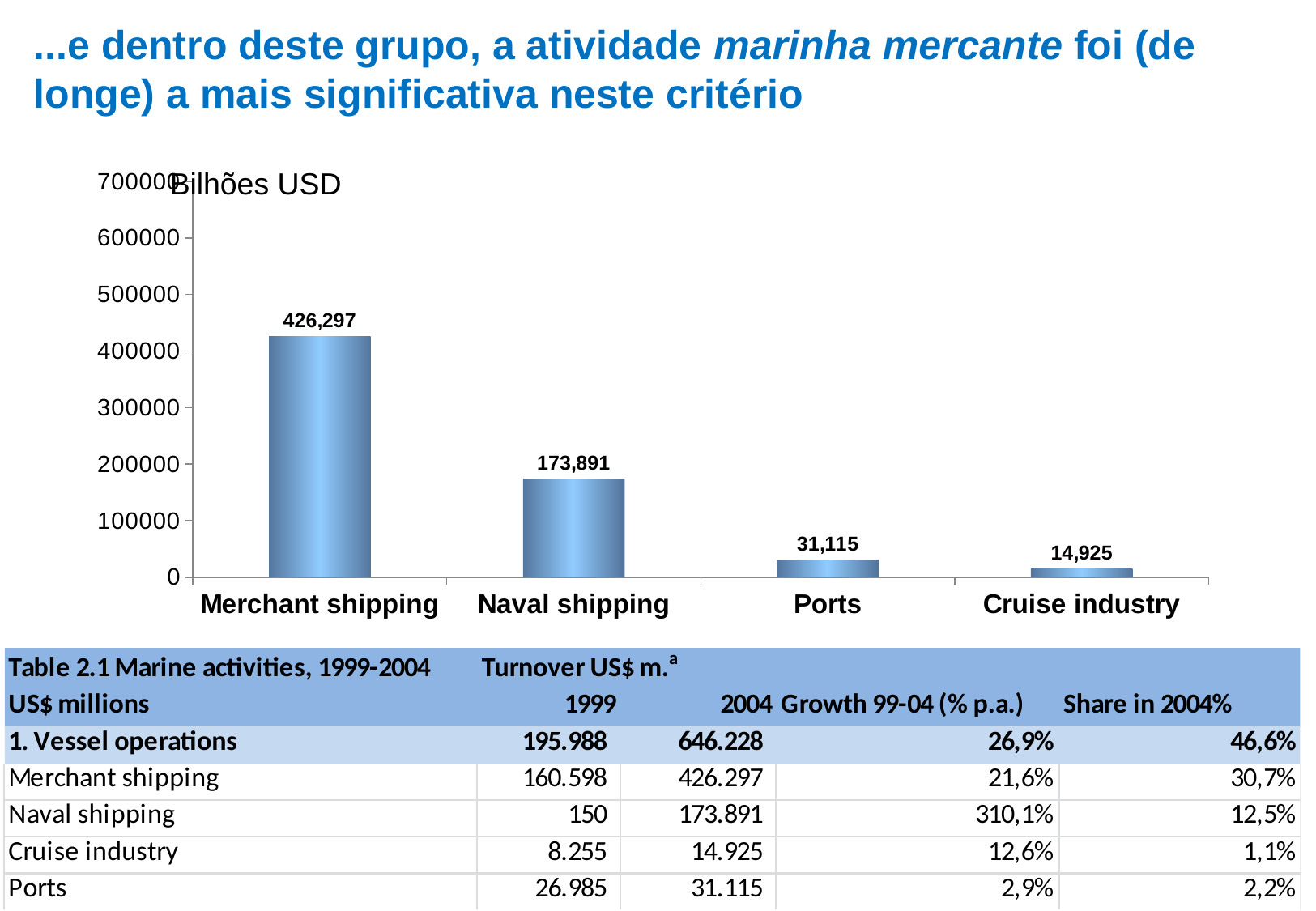
What is the difference between the values for Merchant shipping and Naval shipping in the bar chart? 252,406 Which category has the lowest value in the bar chart? Cruise industry What is the value shown for Cruise industry in the bar chart? 14,925 What is the difference between the values for Ports and Cruise industry in the bar chart? 16,190 Which category has the highest value in the bar chart? Merchant shipping Is the value for Naval shipping in the bar chart greater or less than 200000? less What is the value shown for Merchant shipping in the bar chart? 426,297 What is the value shown for Ports in the bar chart? 31,115 What is the value shown for Naval shipping in the bar chart? 173,891 How many categories are shown in the bar chart? 4 Which is larger in the bar chart, the value for Ports or the value for Cruise industry? Ports What type of chart is shown on the slide? Bar chart